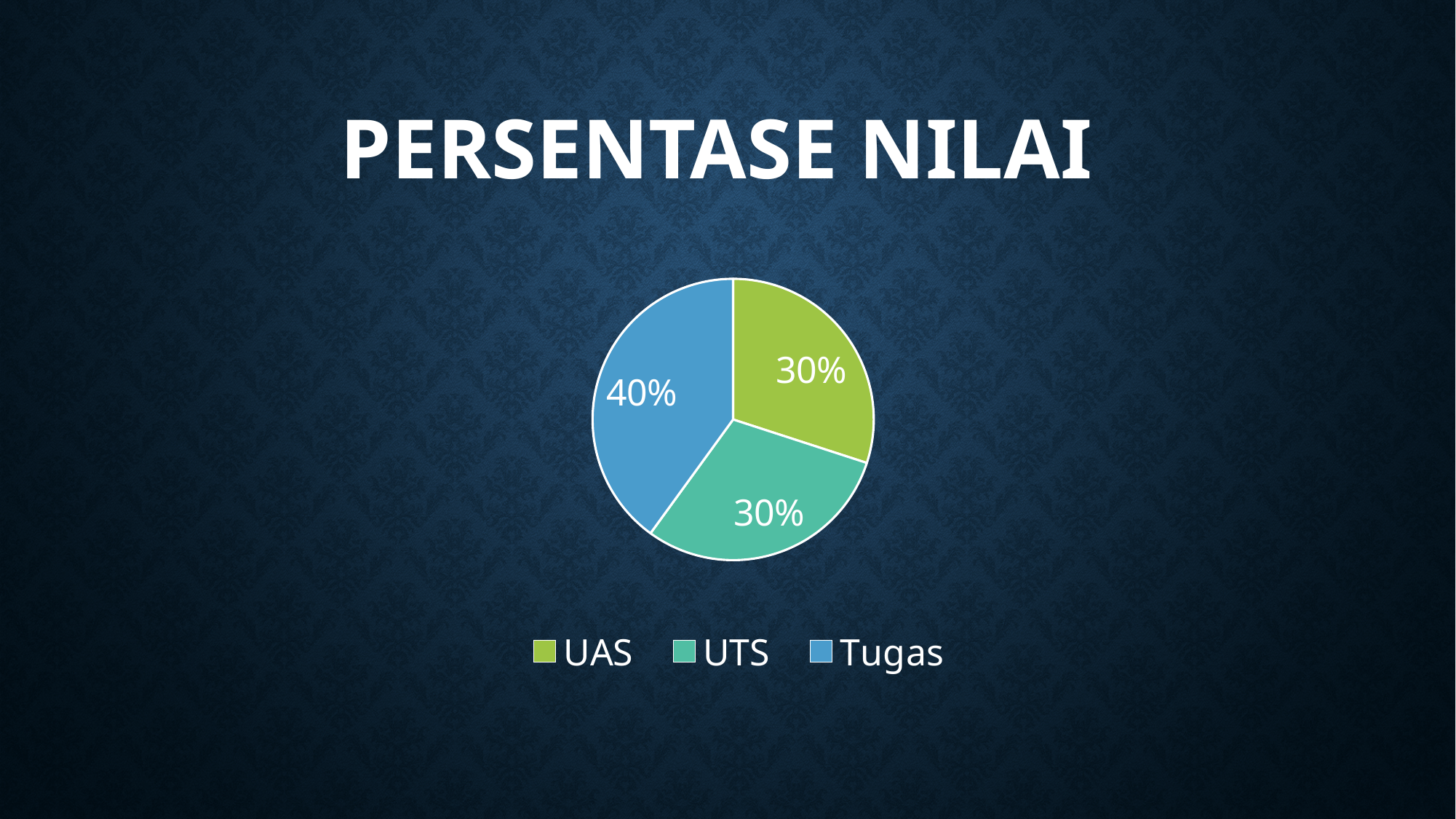
What percentage of the pie is Tugas? 40% How many entries does the legend list? 3 What kind of chart is shown on the slide? pie chart How many slices does the pie chart have? 3 What is the title of the slide containing the chart? PERSENTASE NILAI What percentage of the pie is UAS? 30% What is the difference between the Tugas share and the UAS share? 10% Which category has the largest share of the pie? Tugas What percentage of the pie is UTS? 30% Which is larger, the share for Tugas or the share for UTS? Tugas What is the combined share of UAS and UTS? 60% Which colour represents Tugas in the pie chart? blue